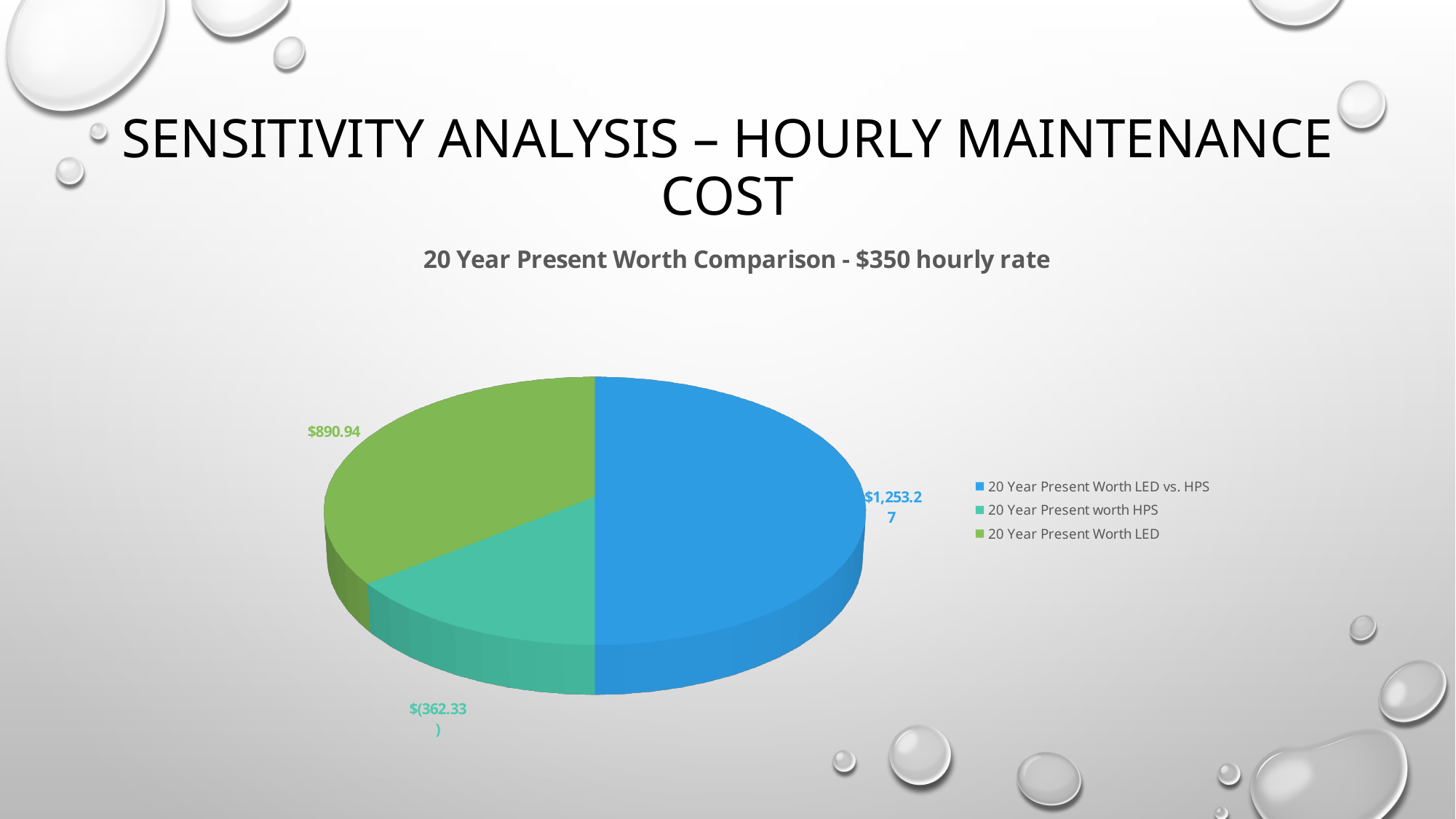
How many slices does the pie chart have? 3 What is the title of the chart? 20 Year Present Worth Comparison - $350 hourly rate What is the value shown for 20 Year Present worth HPS? $(362.33) Which category has the lowest value in the pie chart? 20 Year Present worth HPS Which category has the highest value in the pie chart? 20 Year Present Worth LED vs. HPS What is the value shown for 20 Year Present Worth LED vs. HPS? $1,253.27 What colour is the slice for 20 Year Present Worth LED? Green What kind of chart is shown on the slide? Pie chart How many entries does the legend list? 3 What is the difference between the value for 20 Year Present Worth LED vs. HPS and the value for 20 Year Present Worth LED? $362.33 What is the value shown for 20 Year Present Worth LED? $890.94 Which is larger, the value for 20 Year Present Worth LED vs. HPS or the value for 20 Year Present Worth LED? 20 Year Present Worth LED vs. HPS